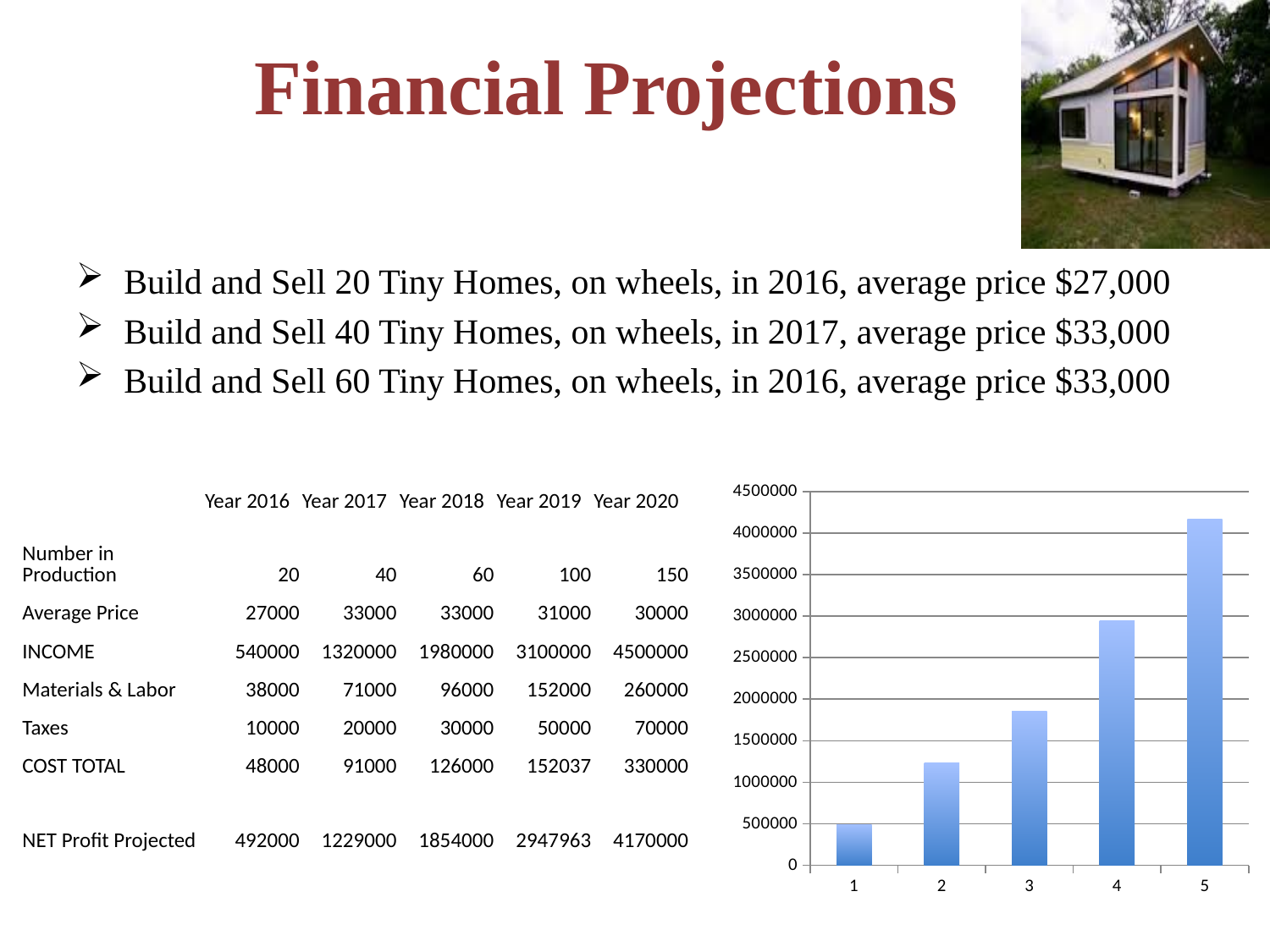
Which category has the highest bar in the chart? 5 Is the value for category 3 greater or less than 2000000? less Do the bar values rise or fall from category 1 to category 5? rise What kind of chart is shown on the slide? bar chart Is the value for category 4 greater or less than 2500000? greater Is the value for category 5 greater or less than 4000000? greater Which category has the lowest bar in the chart? 1 How many bars does the chart show? 5 Which is larger, the bar for category 3 or the bar for category 4? 4 What is the highest value shown on the chart's vertical axis? 4500000